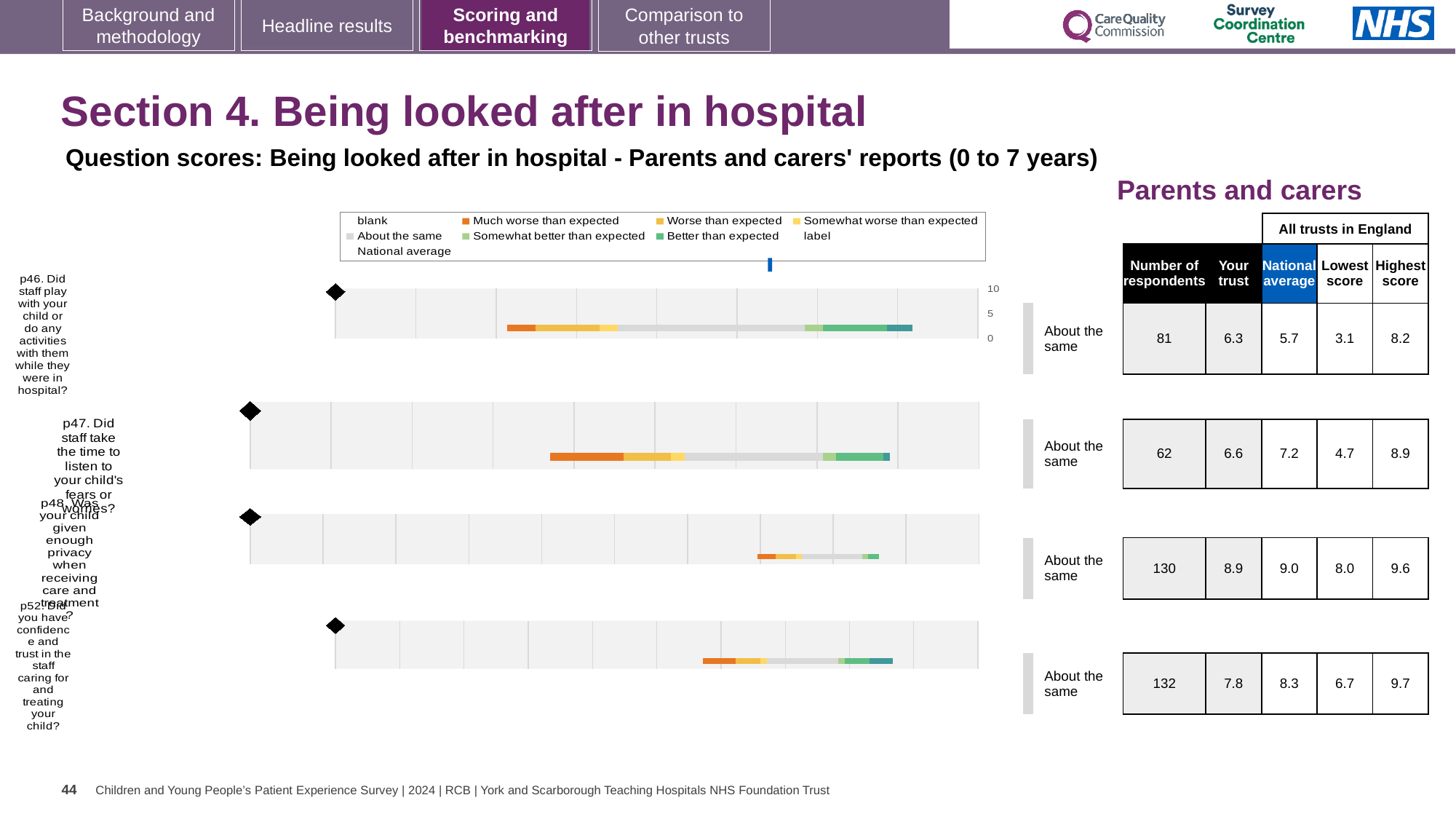
What is the 'Your trust' score for p46 (Did staff play with your child or do any activities with them while they were in hospital?)? 6.3 What benchmark category is shown for p52? About the same How many respondents answered p48 (Was your child given enough privacy when receiving care and treatment?)? 130 What is the heading above the table of scores on the right of the slide? Parents and carers What is the highest score among all trusts in England for p52 (Did you have confidence and trust in the staff caring for and treating your child?)? 9.7 Which question has the highest 'Your trust' score? p48 Which question has the lowest 'Your trust' score? p46 How many survey questions (bar charts) are shown on the slide? 4 For p46, which is larger: the 'Your trust' score or the national average? Your trust What kind of chart is used to show the question scores on this slide? bar chart For p47, what is the difference between the national average and the 'Your trust' score? 0.6 What is the national average score for p47 (Did staff take the time to listen to your child's fears or worries?)? 7.2